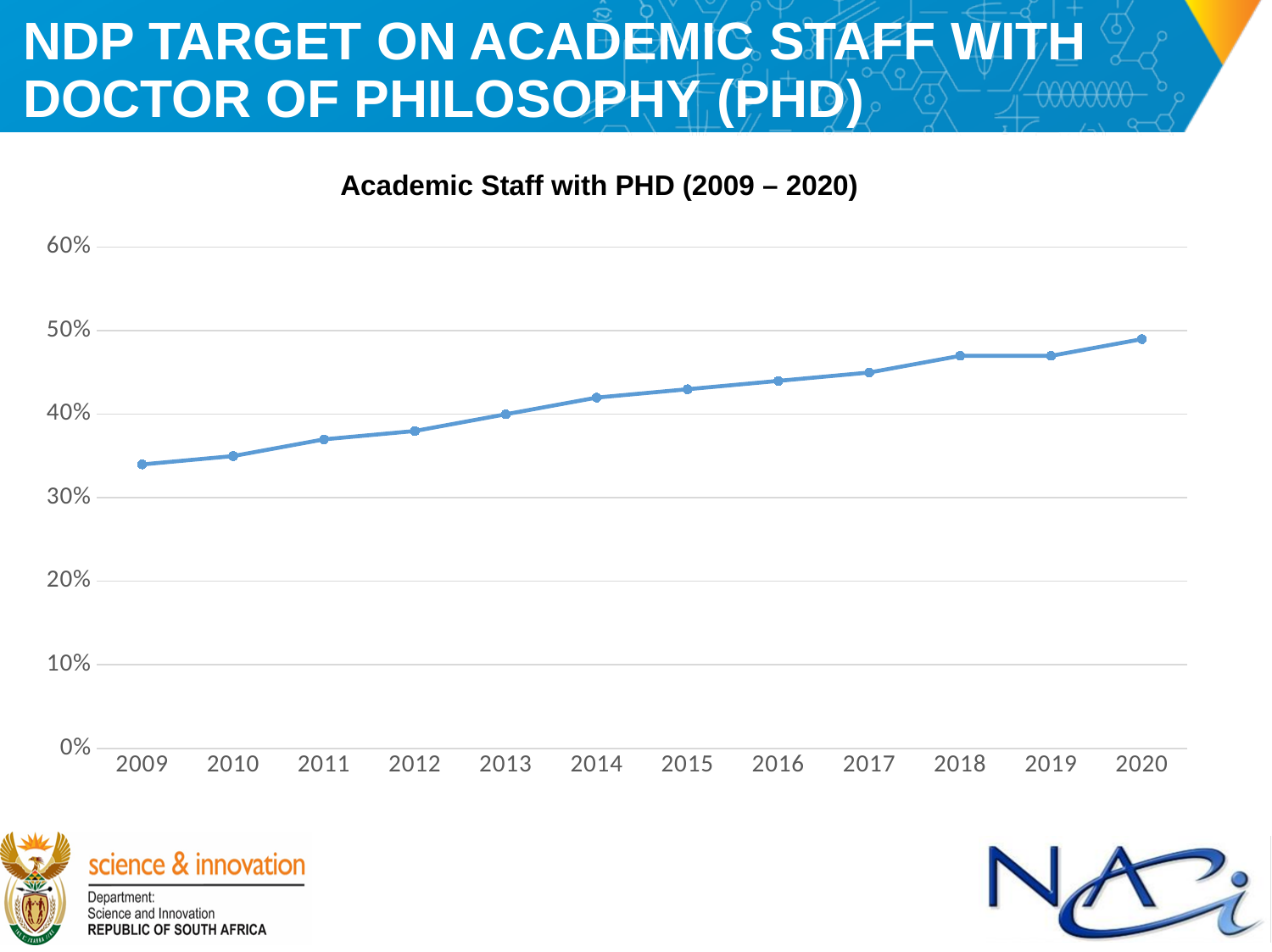
What is the title of the chart? Academic Staff with PHD (2009 – 2020) Which year has the highest share of academic staff with a PhD? 2020 What kind of chart is shown on the slide? line chart Which year has the larger value, 2012 or 2018? 2018 Is the value for 2011 greater or less than 30%? greater Is the value for 2020 greater or less than 50%? less Do the values generally rise or fall from 2009 to 2020? rise What is the highest value shown on the y axis of the chart? 60% Which year has the lowest share of academic staff with a PhD? 2009 Is the value for 2016 greater or less than 40%? greater How many years are plotted on the x axis of the chart? 12